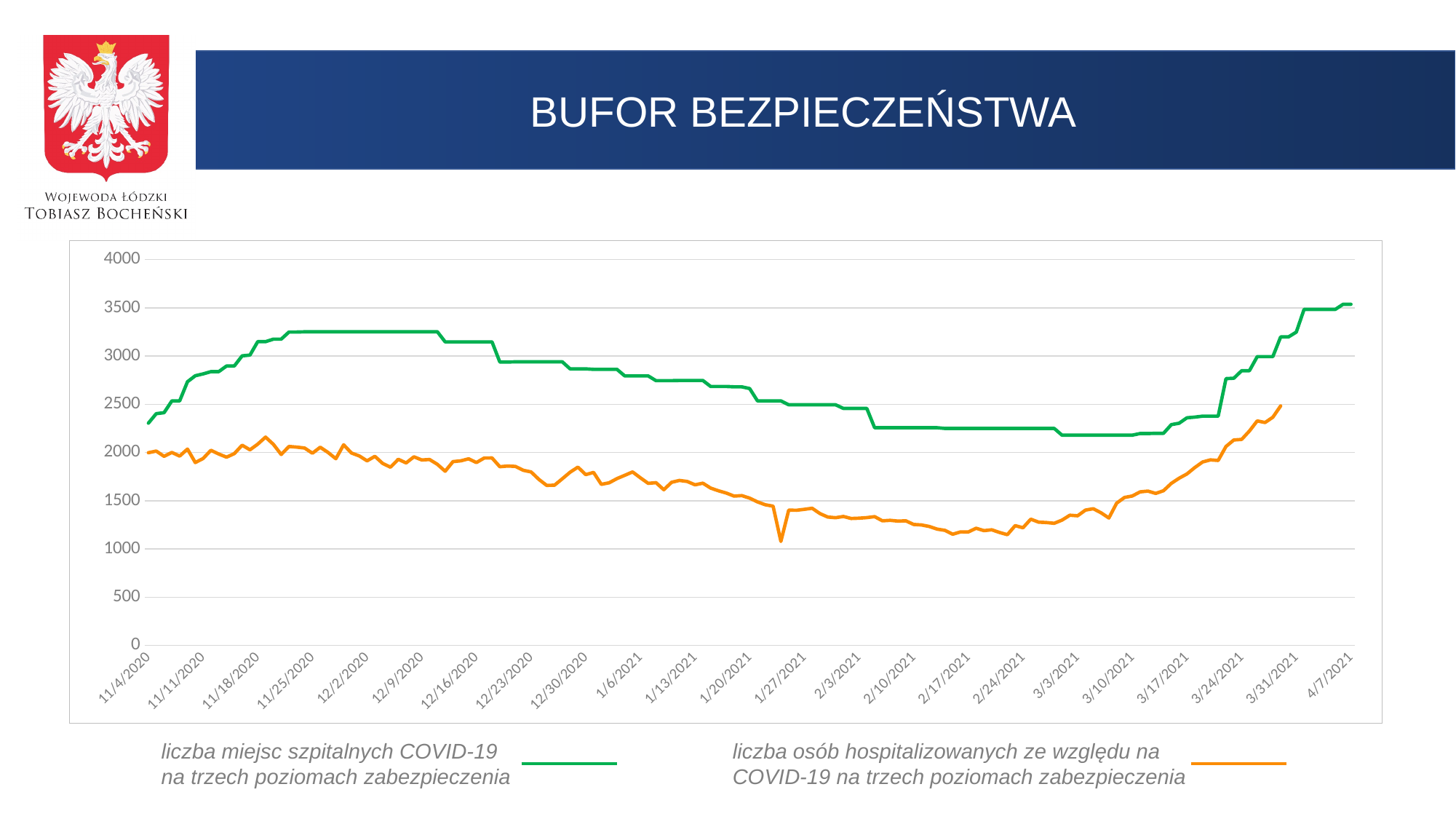
Is the value of 'liczba osób hospitalizowanych ze względu na COVID-19 na trzech poziomach zabezpieczenia' on 2/17/2021 greater or less than 1500? less Which series has the higher value on 12/2/2020: 'liczba miejsc szpitalnych COVID-19 na trzech poziomach zabezpieczenia' or 'liczba osób hospitalizowanych ze względu na COVID-19 na trzech poziomach zabezpieczenia'? liczba miejsc szpitalnych COVID-19 na trzech poziomach zabezpieczenia Is the value of 'liczba miejsc szpitalnych COVID-19 na trzech poziomach zabezpieczenia' on 3/3/2021 greater or less than 2500? less What colour is the line for 'liczba osób hospitalizowanych ze względu na COVID-19 na trzech poziomach zabezpieczenia'? orange Is the value of 'liczba miejsc szpitalnych COVID-19 na trzech poziomach zabezpieczenia' on 11/4/2020 greater or less than 2000? greater What is the title of the slide containing the chart? BUFOR BEZPIECZEŃSTWA What kind of chart is shown on the slide? line chart How many series does the legend list? 2 Does the 'liczba miejsc szpitalnych COVID-19 na trzech poziomach zabezpieczenia' line rise or fall between 3/17/2021 and 4/7/2021? rise Does the 'liczba osób hospitalizowanych ze względu na COVID-19 na trzech poziomach zabezpieczenia' line rise or fall between 12/2/2020 and 2/17/2021? fall